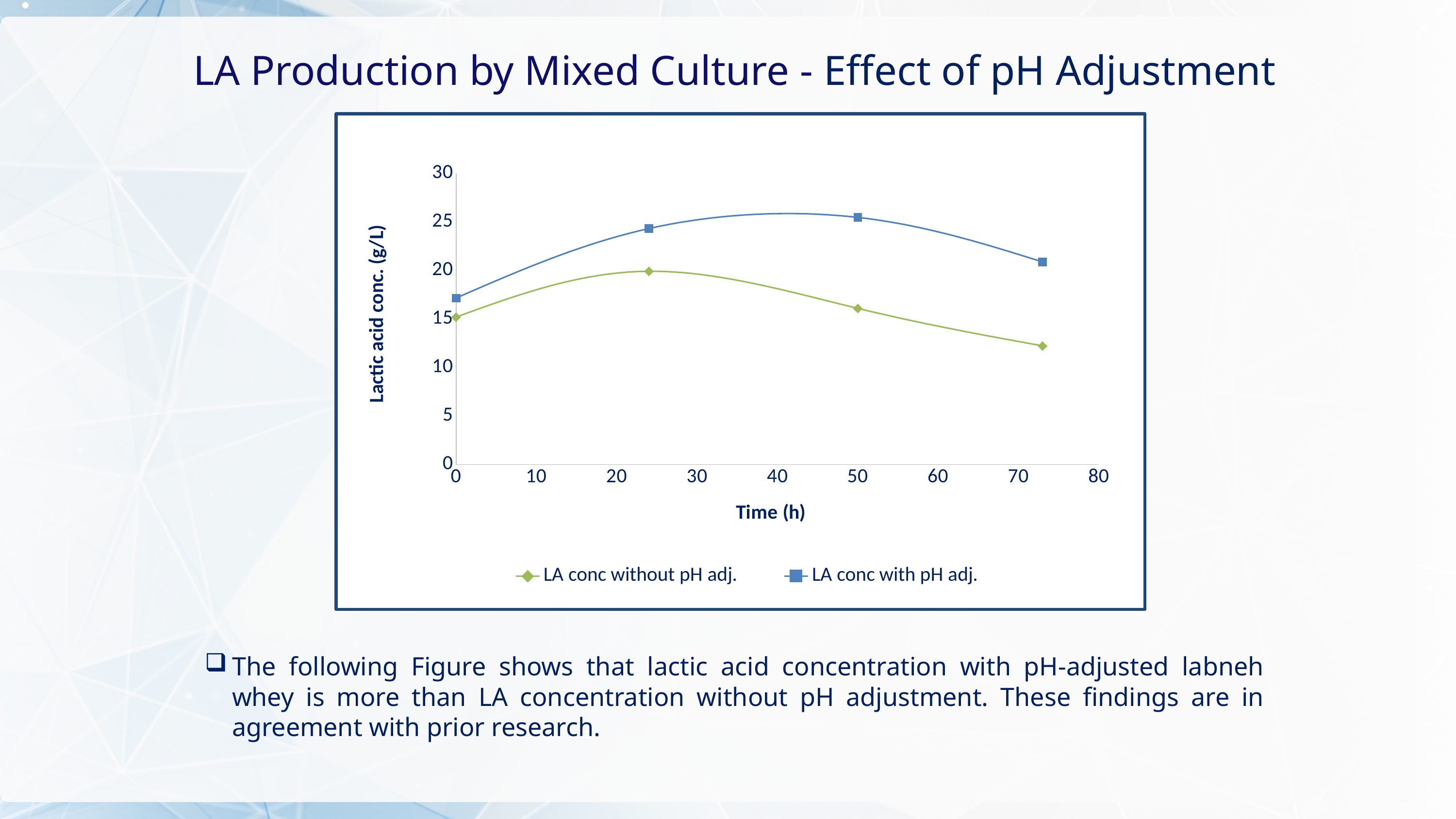
Is the value for 'LA conc with pH adj.' at about 50 h greater or less than 20? greater Which series reaches the highest lactic acid concentration on the chart? LA conc with pH adj. Is the value for 'LA conc without pH adj.' at its last time point greater or less than 15? less What kind of chart is shown on the slide? line chart Does the 'LA conc without pH adj.' series rise or fall between about 24 h and its last time point? fall At about 50 h, which series has the higher lactic acid concentration? LA conc with pH adj. What is the label of the x axis? Time (h) Is the value for 'LA conc with pH adj.' at 0 h greater or less than 15? greater How many series does the legend list? 2 How many data points are plotted for the 'LA conc with pH adj.' series? 4 What is the label of the y axis? Lactic acid conc. (g/L)